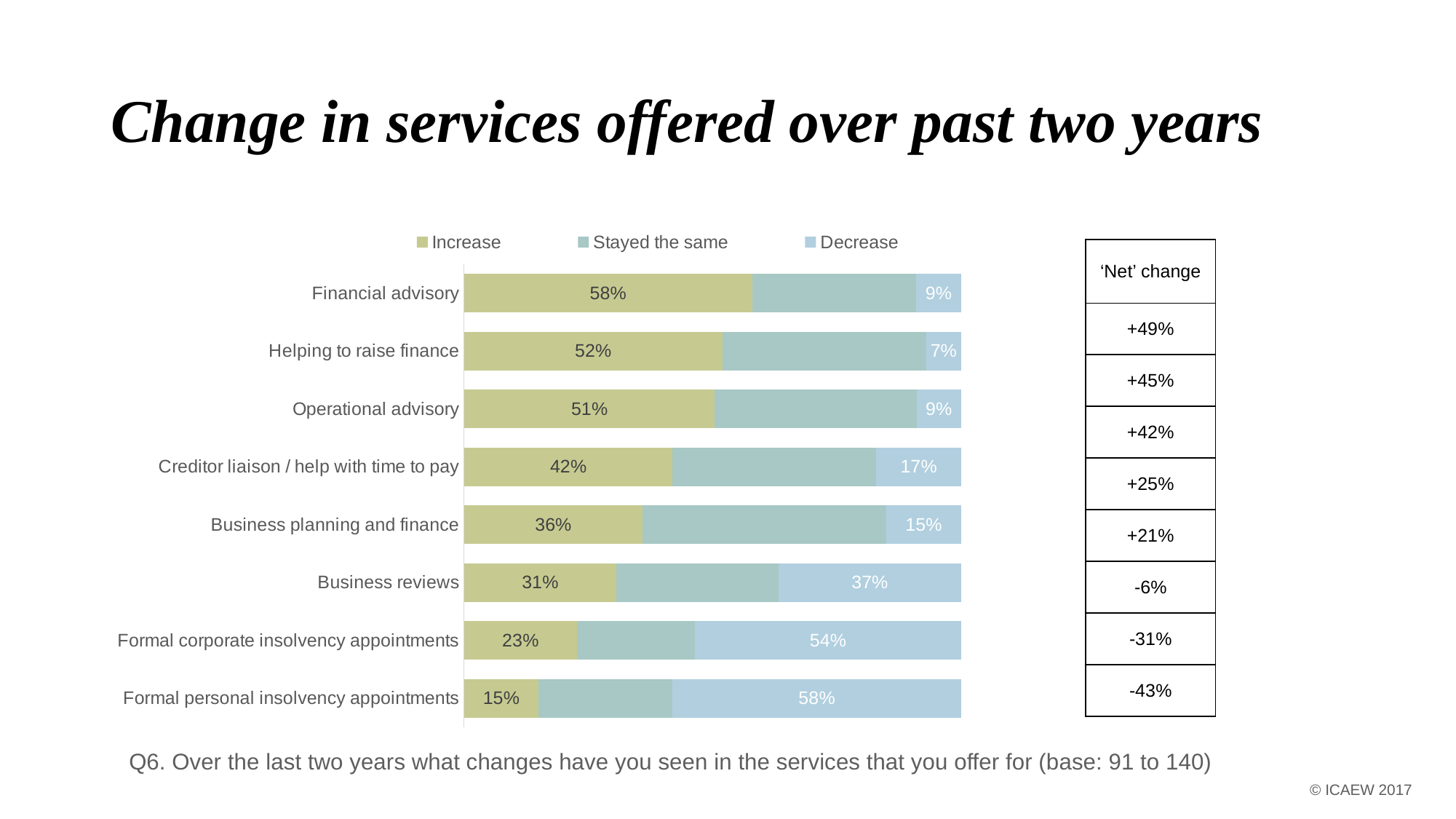
Which category has the highest Increase value? Financial advisory Which category has the lowest Decrease value? Helping to raise finance How many service categories are shown in the chart? 8 How many series does the chart legend list? 3 What is the Decrease value for Formal corporate insolvency appointments? 54% What kind of chart is shown on the slide? Stacked bar chart What is the difference between the Increase values for Helping to raise finance and Business reviews? 21% Which is larger: the Decrease value for Business reviews or the Decrease value for Business planning and finance? Business reviews Which category has the highest Decrease value? Formal personal insolvency appointments Which legend entry is shown in the lightest blue colour? Decrease What is the Increase value for Creditor liaison / help with time to pay? 42% What is the Increase value for Financial advisory? 58%